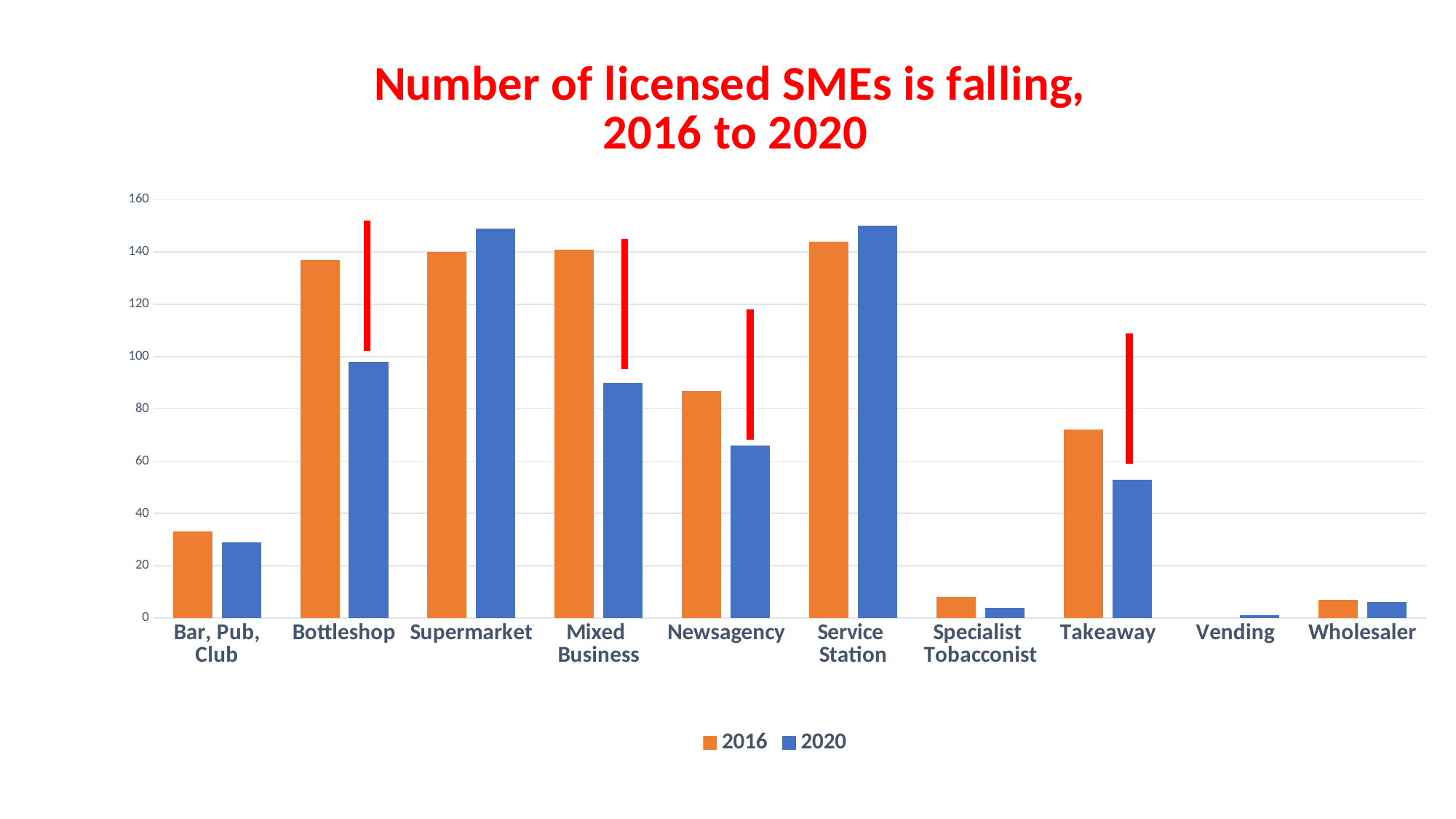
What kind of chart is shown on the slide? bar chart Which category has the lowest value for 2020? Vending What is the title of the chart? Number of licensed SMEs is falling, 2016 to 2020 For Bottleshop, which is larger: the 2016 value or the 2020 value? 2016 Which colour represents the 2020 series in the legend? blue For Takeaway, which is larger: the 2016 value or the 2020 value? 2016 How many series does the legend list? 2 How many business categories are shown on the x axis? 10 Is the 2016 value for Takeaway greater or less than 60? greater For Supermarket, which is larger: the 2016 value or the 2020 value? 2020 Is the 2020 value for Service Station greater or less than 140? greater